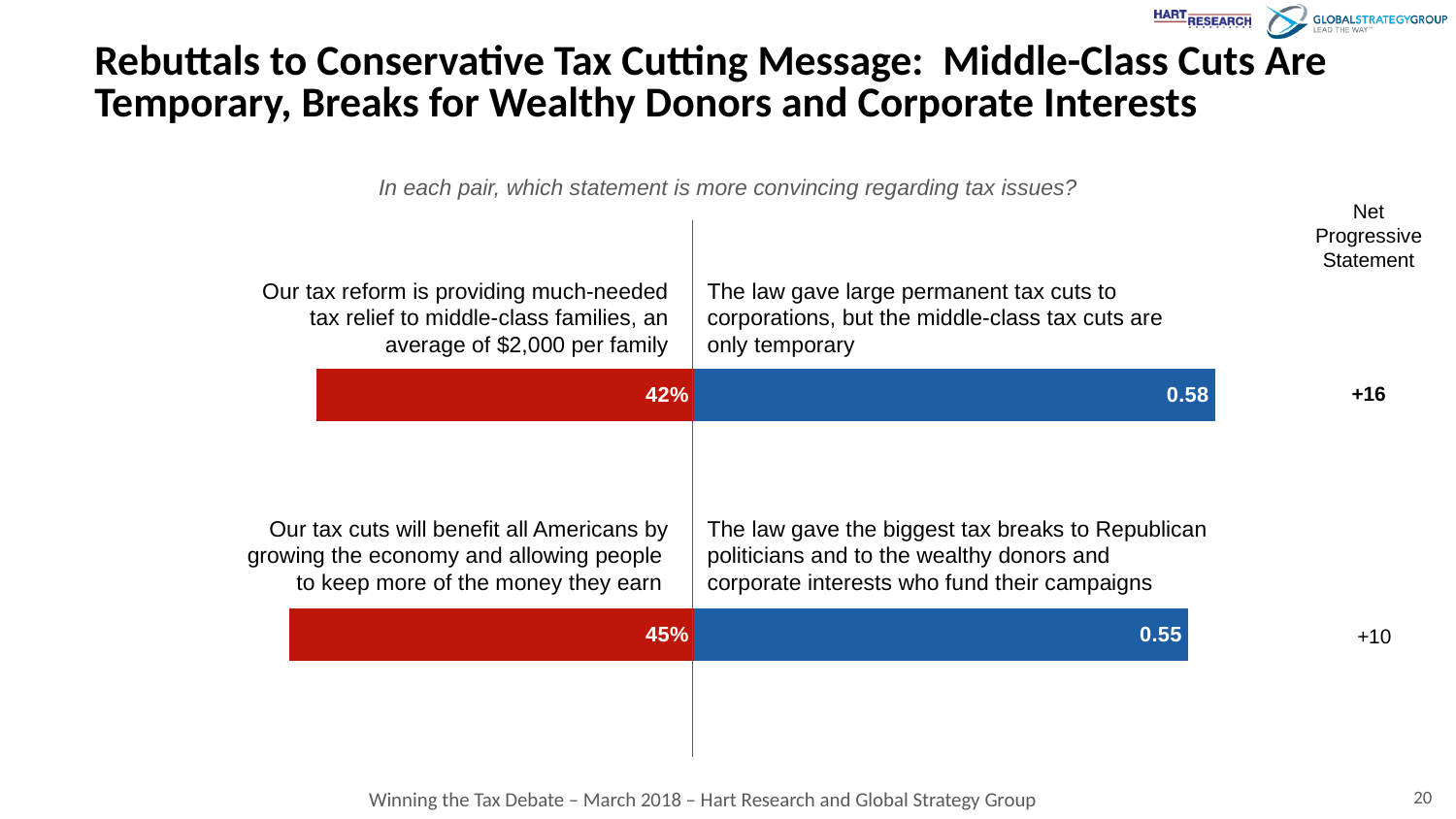
What value is printed on the blue bar for the statement 'The law gave large permanent tax cuts to corporations, but the middle-class tax cuts are only temporary'? 0.58 Which of the two red bars has the higher value? the second pair's red bar (45%) What percentage is shown for the red bar for the statement 'Our tax cuts will benefit all Americans by growing the economy'? 45% In the first pair, which bar is longer, the red bar or the blue bar? the blue bar What is the Net Progressive Statement value for the first pair of statements? +16 What value is printed on the blue bar for the statement 'The law gave the biggest tax breaks to Republican politicians and to the wealthy donors'? 0.55 What kind of chart is shown on the slide? bar chart What colour are the bars for the progressive statements on the right side of the chart? blue What is the Net Progressive Statement value for the second pair of statements? +10 What is the difference between the two red bar values, 45% and 42%? 3 percentage points What percentage is shown for the red bar in the first pair, for the statement 'Our tax reform is providing much-needed tax relief to middle-class families'? 42% How many pairs of statements are shown on the chart? 2